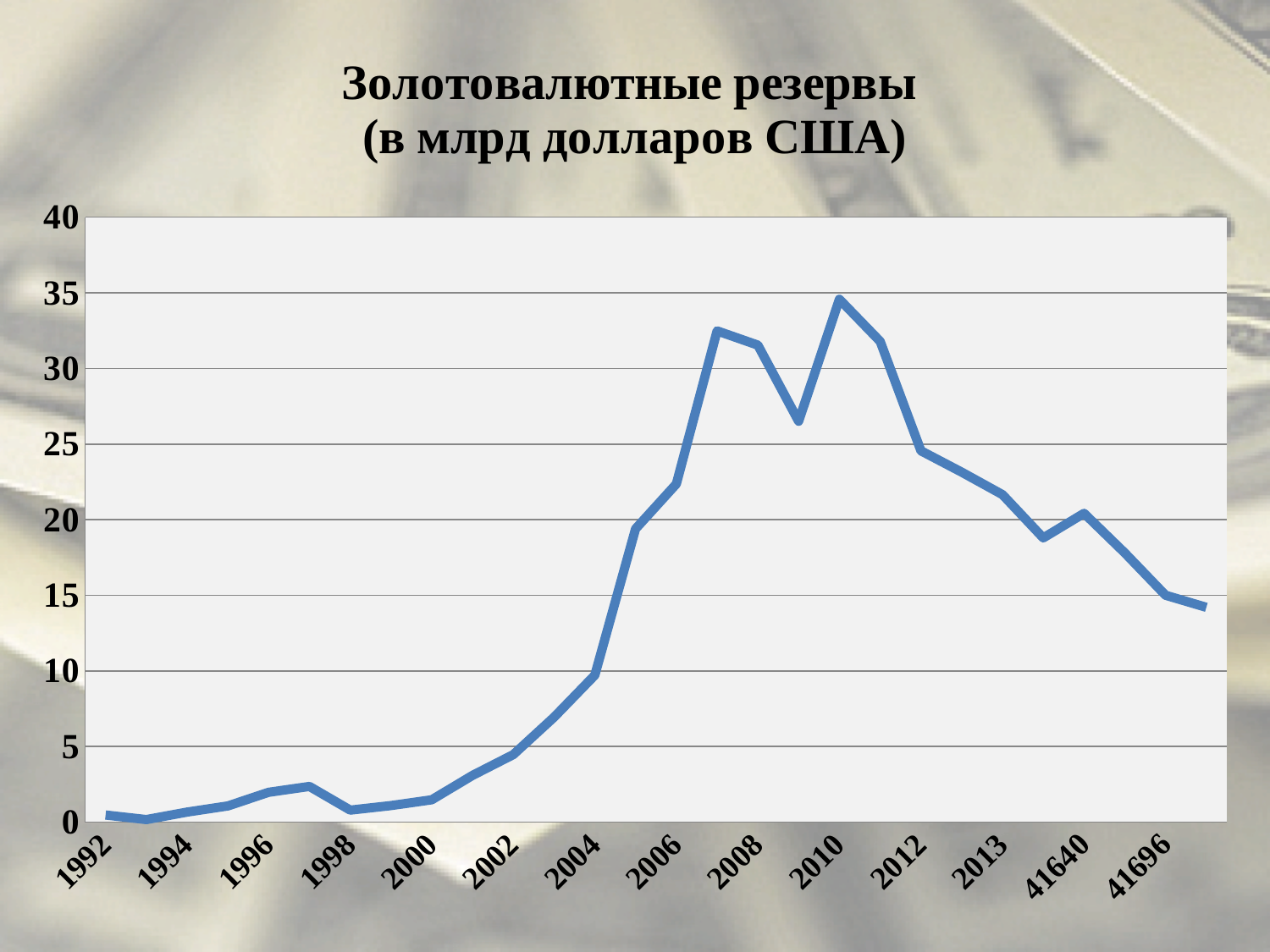
Is the value for 2010 greater or less than 30? greater In which labelled year does the line reach its highest value? 2010 Is the value for 2008 greater or less than 30? greater Which is larger, the value for 2008 or the value for 2012? 2008 Is the value for 2000 greater or less than 5? less Does the line generally rise or fall between 1992 and 2010? rise Which is larger, the value for 2004 or the value for 2006? 2006 Does the line generally rise or fall between 2010 and the last point on the x axis? fall What is the title of the chart? Золотовалютные резервы (в млрд долларов США) What kind of chart is shown on the slide? line chart